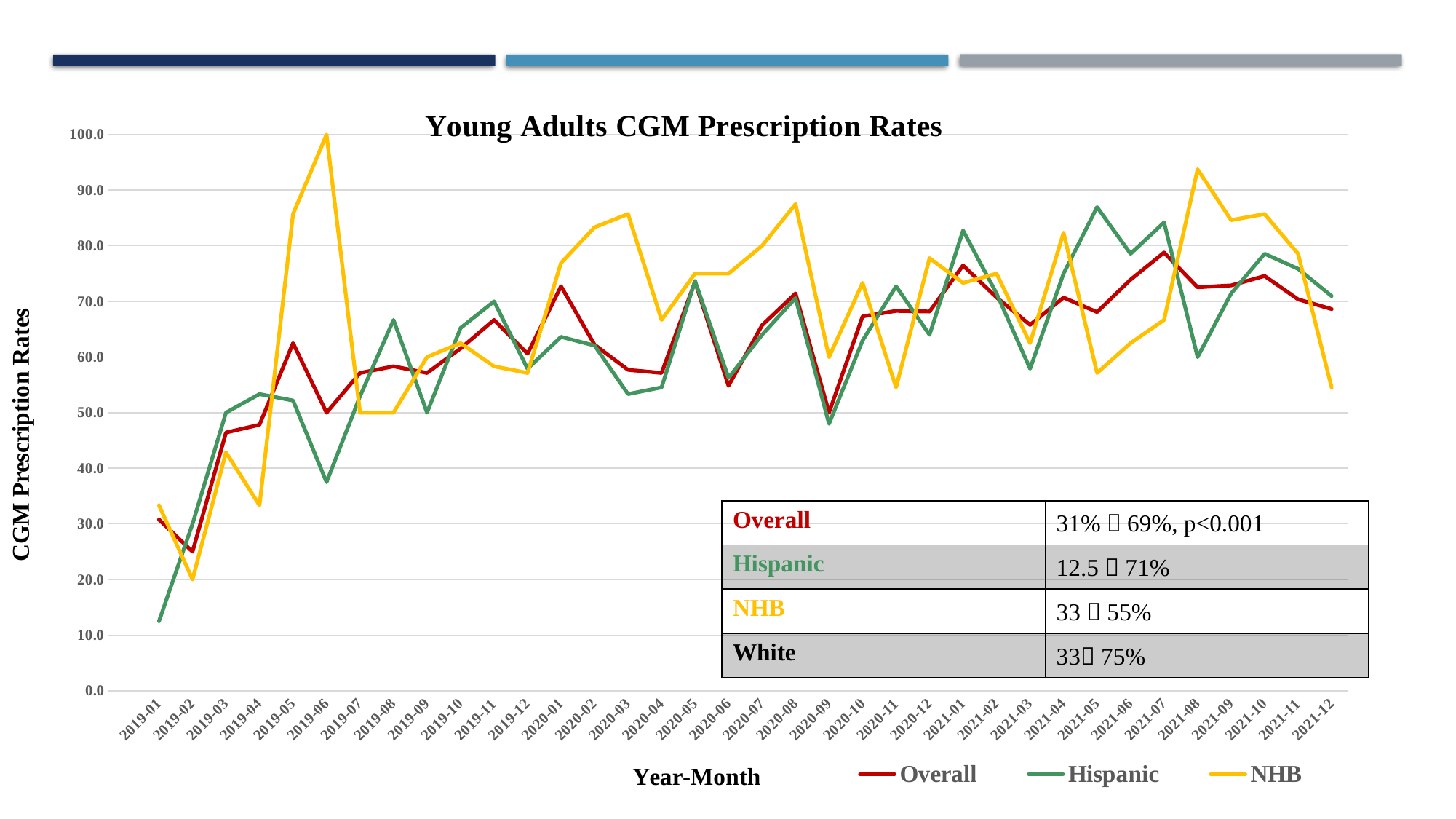
Which series has the lowest value anywhere on the chart? Hispanic Which series are listed in the chart legend? Overall, Hispanic, NHB What kind of chart is shown on the slide? line chart Is the value for NHB at 2019-06 greater or less than 90? greater Is the value for NHB at 2021-12 greater or less than 60? less How many series does the chart legend list? 3 Which series reaches the highest value anywhere on the chart? NHB At 2019-06, which series has the larger value, NHB or Hispanic? NHB How many year-month points are shown along the x axis? 36 Does the Overall series generally rise or fall from 2019-01 to 2021-12? rise What is the title of the chart? Young Adults CGM Prescription Rates Is the value for Hispanic at 2019-01 greater or less than 20? less